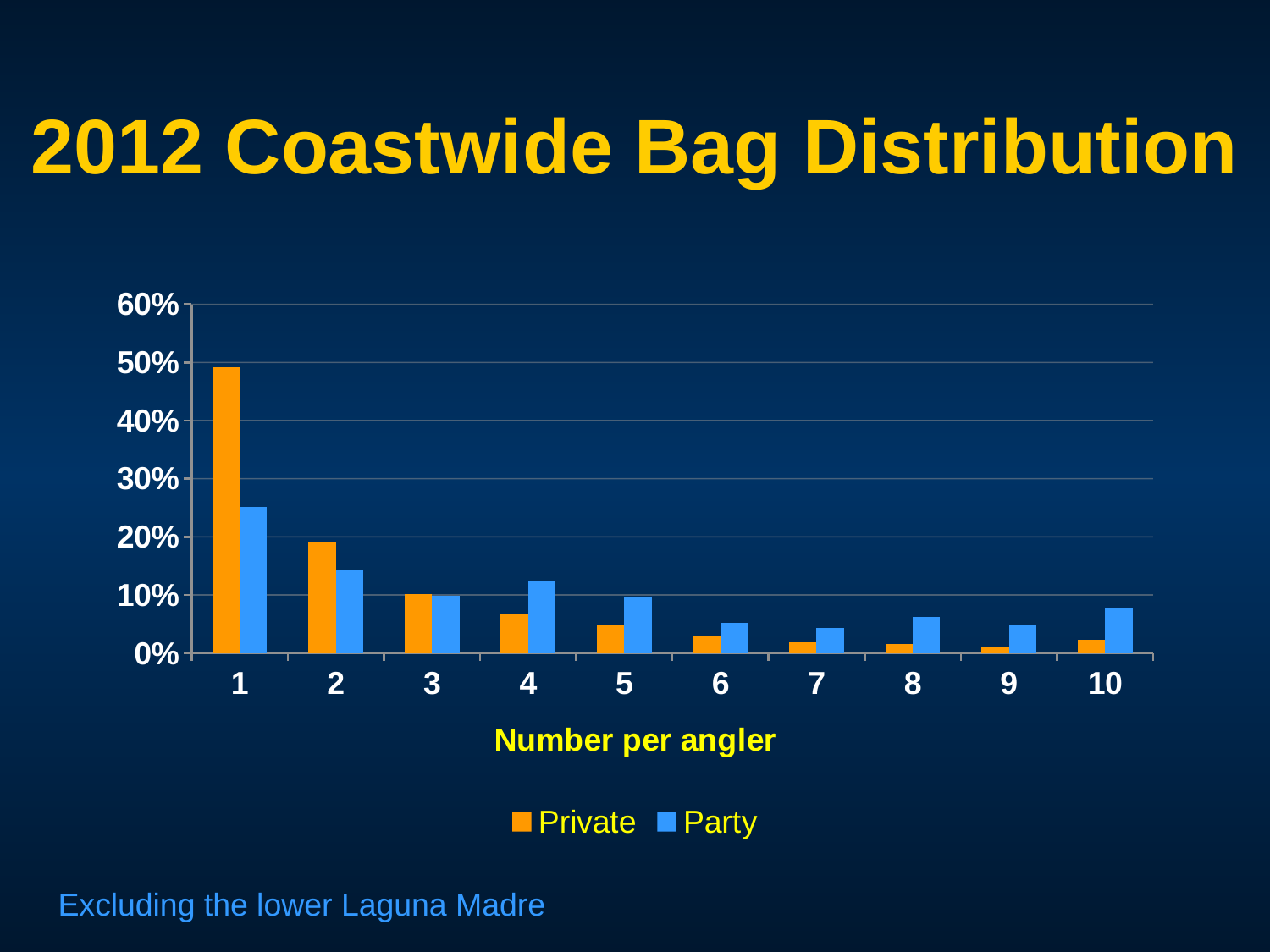
How many series does the legend list? 2 Is the Party value at 1 per angler greater or less than 20%? greater What kind of chart is shown on the slide? bar chart At 1 per angler, which series has the larger value, Private or Party? Private For which number per angler is the Private value highest? 1 Is the Private value at 1 per angler greater or less than 40%? greater For which number per angler is the Party value highest? 1 What is the title of the x axis? Number per angler Do the Private values generally rise or fall as the number per angler increases from 1 to 9? fall How many categories are shown along the x axis? 10 At 4 per angler, which series has the larger value, Private or Party? Party For which number per angler is the Private value lowest? 9